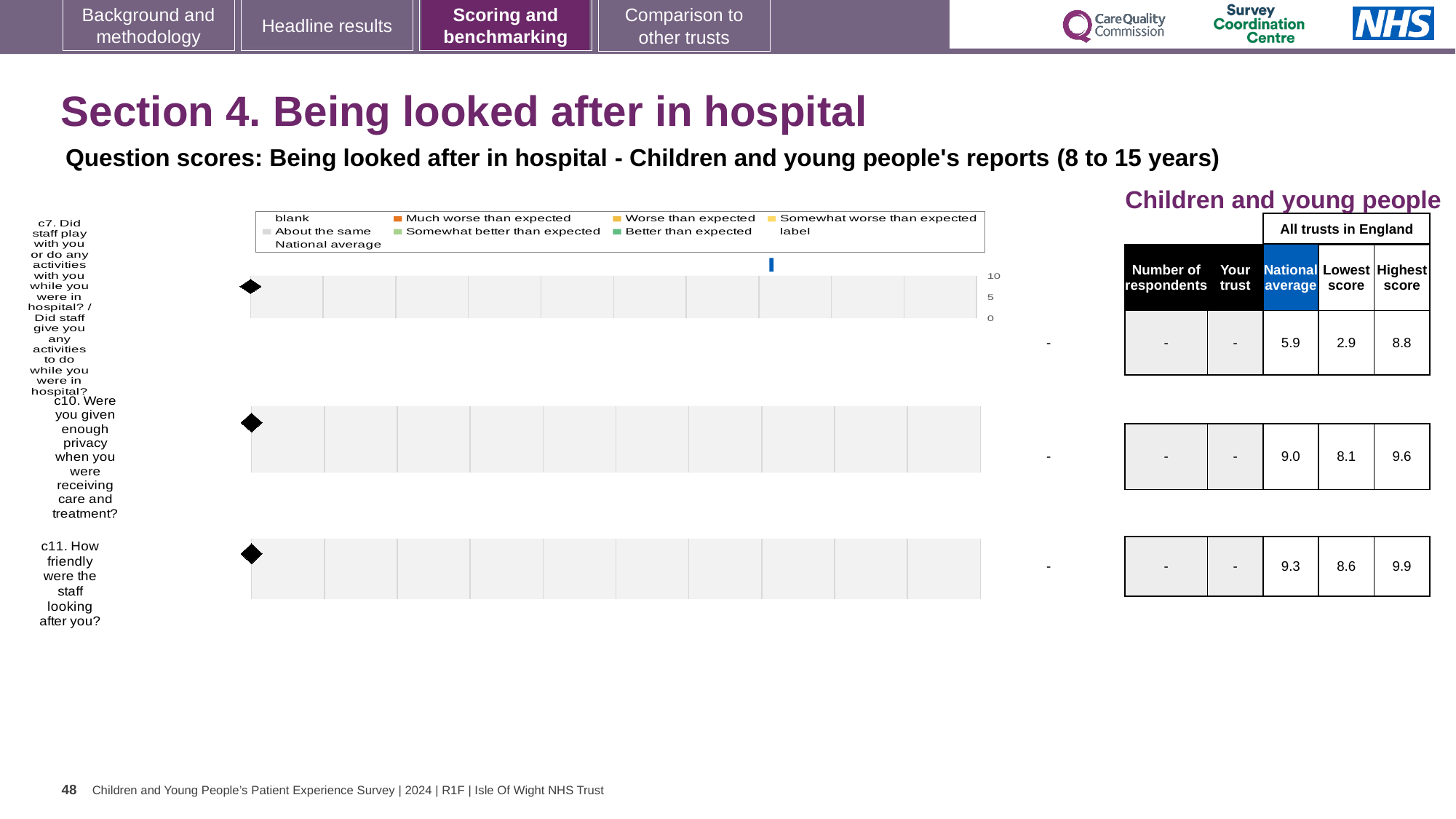
What kind of chart is shown on the slide? bar chart What is the difference between the highest score and the lowest score for question c10? 1.5 What is the highest score across all trusts in England for question c11 (How friendly were the staff looking after you?)? 9.9 What colour does the legend use for 'Much worse than expected'? orange Which has the larger national average score: question c10 or question c11? c11 What value is shown for 'Your trust' for question c7? - What is the maximum value shown on the chart's horizontal axis? 10 Which question has the highest national average score? c11. How friendly were the staff looking after you? How many survey questions (categories) are listed on the chart's vertical axis? 3 Which question has the lowest national average score? c7. Did staff play with you or do any activities with you while you were in hospital? What is the national average score for question c10 (Were you given enough privacy when you were receiving care and treatment?)? 9.0 What is the lowest score across all trusts in England for question c7 (Did staff play with you or do any activities with you while you were in hospital?)? 2.9